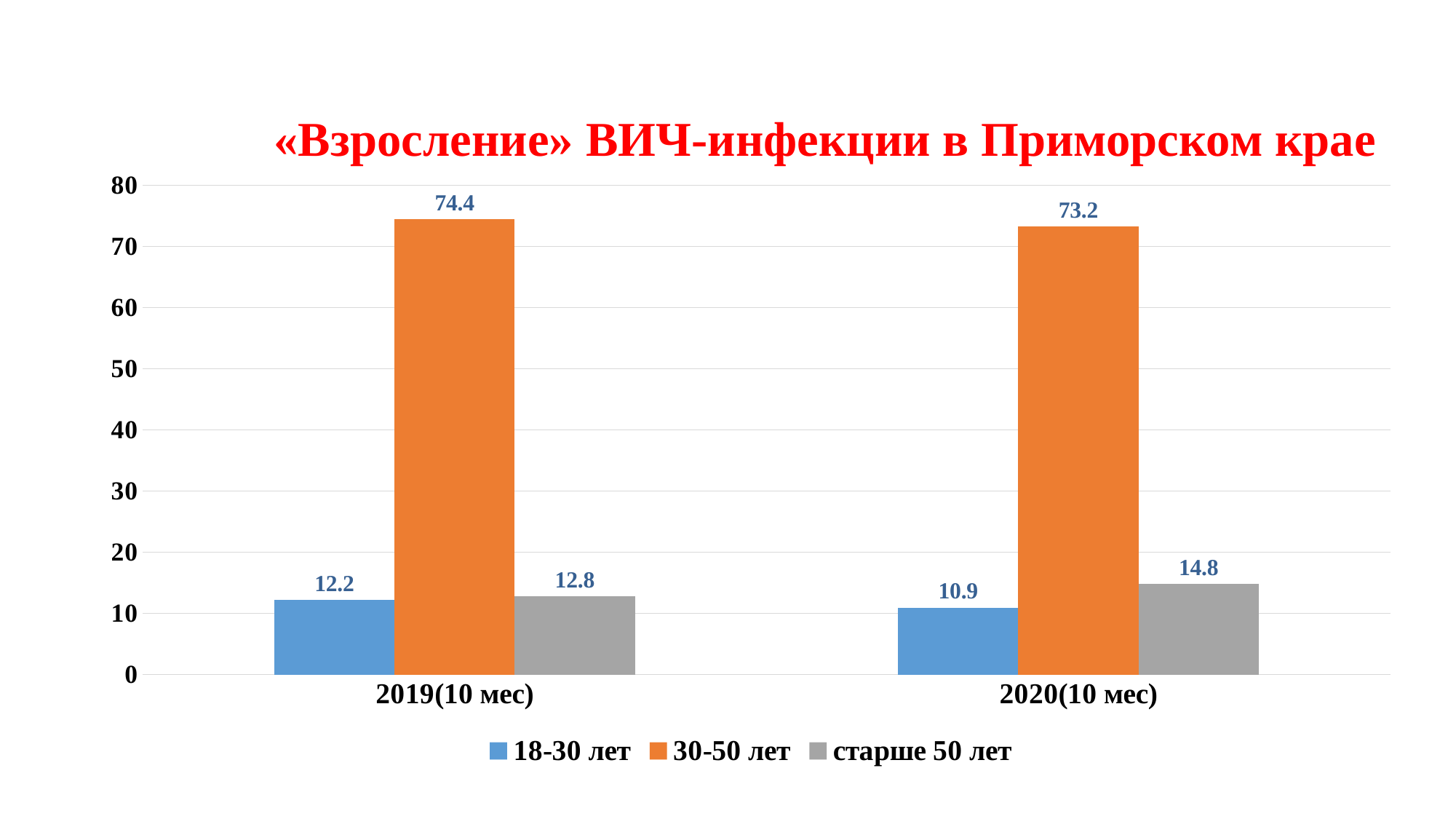
What is the value for the 30-50 лет series in 2019(10 мес)? 74.4 Is the value for 30-50 лет in 2019(10 мес) greater or less than 70? greater What is the value for the старше 50 лет series in 2019(10 мес)? 12.8 What is the title of the chart? «Взросление» ВИЧ-инфекции в Приморском крае Which series has the lowest value in 2019(10 мес)? 18-30 лет What kind of chart is shown on the slide? Bar chart What is the value for the 18-30 лет series in 2020(10 мес)? 10.9 Which series has the highest value in 2020(10 мес)? 30-50 лет What is the value for the старше 50 лет series in 2020(10 мес)? 14.8 What is the difference between the 30-50 лет values for 2019(10 мес) and 2020(10 мес)? 1.2 Which is larger: the старше 50 лет value in 2019(10 мес) or in 2020(10 мес)? 2020(10 мес) How many series does the legend list? 3